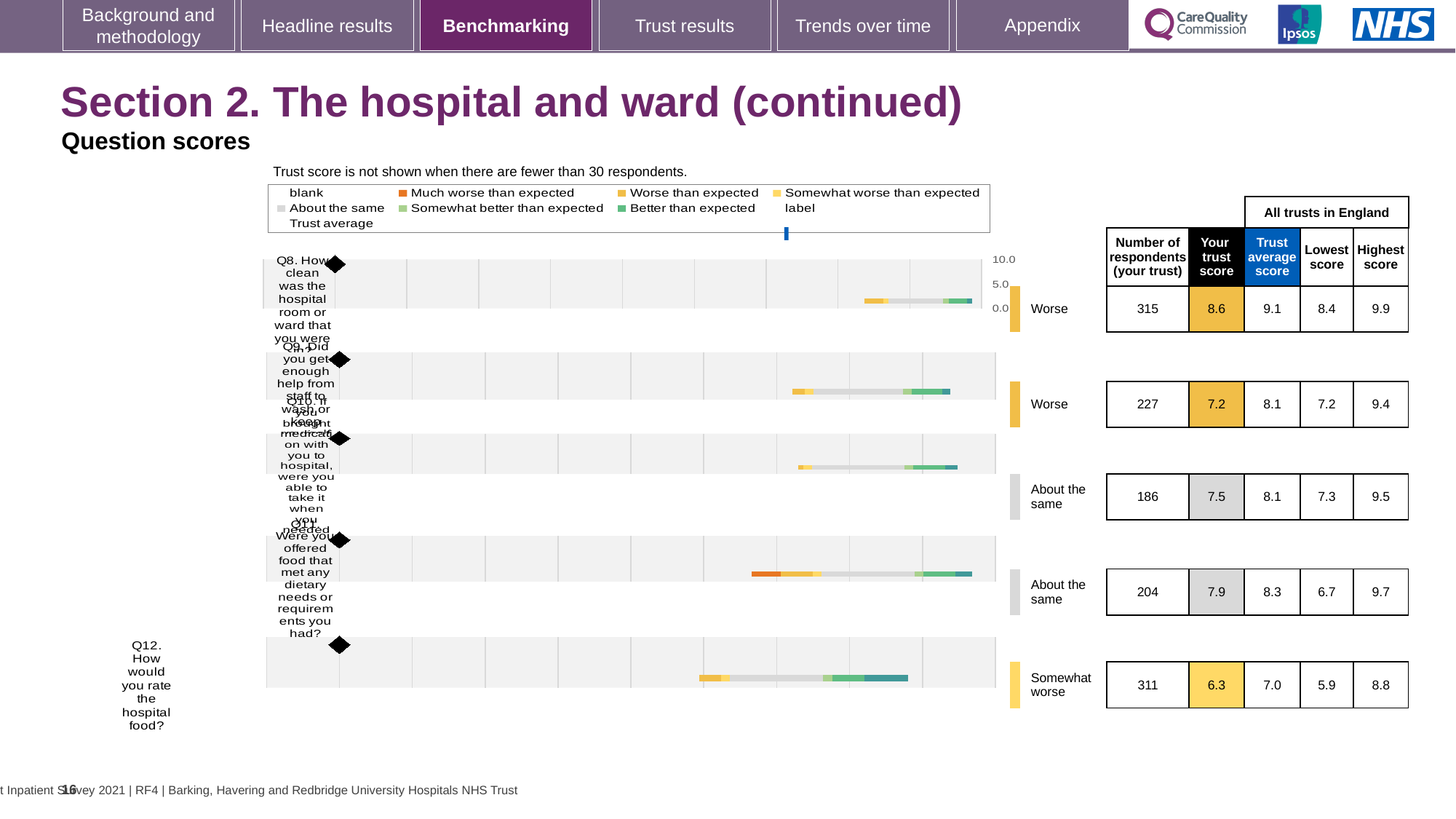
Which question has the highest trust score? Q8 Which has the larger trust score, Q9 or Q10? Q10 How many questions (rows) are plotted in the question scores chart? 5 Which question has the lowest trust score? Q12 What is the trust score for Q8 (how clean was the hospital room or ward)? 8.6 What kind of chart is used to show the question scores on this slide? bar chart What is the lowest score across all trusts in England for Q9? 7.2 What benchmark category label is shown next to Q12? Somewhat worse What is the difference between the highest and lowest scores for Q12? 2.9 What is the highest score across all trusts in England for Q11? 9.7 How many respondents answered Q12 (how would you rate the hospital food)? 311 What is the difference between the trust average score and the trust score for Q8? 0.5